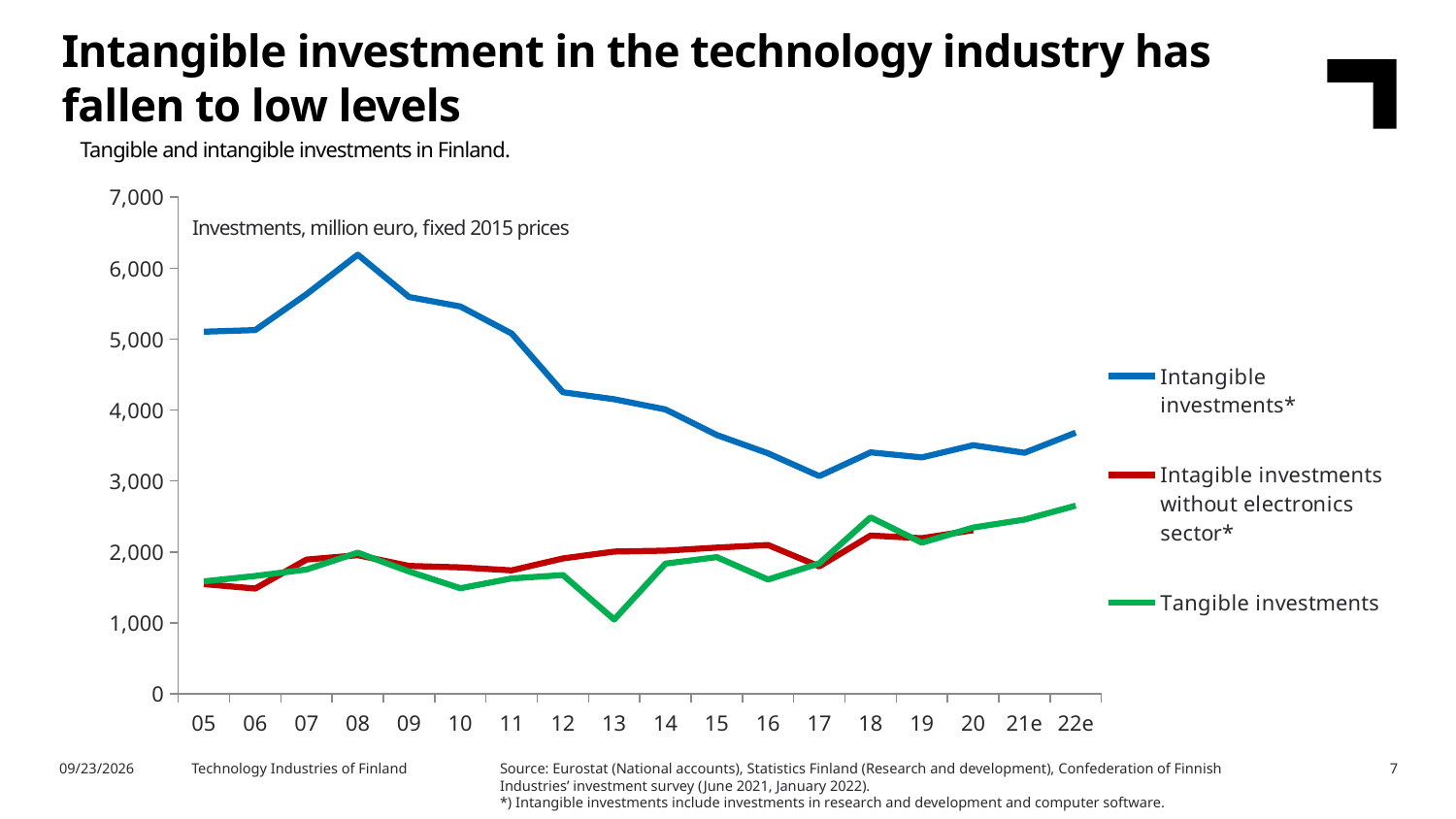
In which year do Intangible investments* reach their highest value? 08 What kind of chart is shown on the slide? line chart In 13, which is larger: Tangible investments or Intagible investments without electronics sector*? Intagible investments without electronics sector* Is the value for Tangible investments in 10 greater or less than 2,000? less How many years are plotted along the x axis? 18 In which year do Intangible investments* reach their lowest value? 17 Is the value for Intangible investments* in 08 greater or less than 6,000? greater Do Intangible investments* rise or fall between 08 and 17? fall What unit is stated for the investments in the chart? million euro, fixed 2015 prices Is the value for Intangible investments* in 15 greater or less than 4,000? less How many series does the legend list? 3 In which year do Tangible investments reach their lowest value? 13